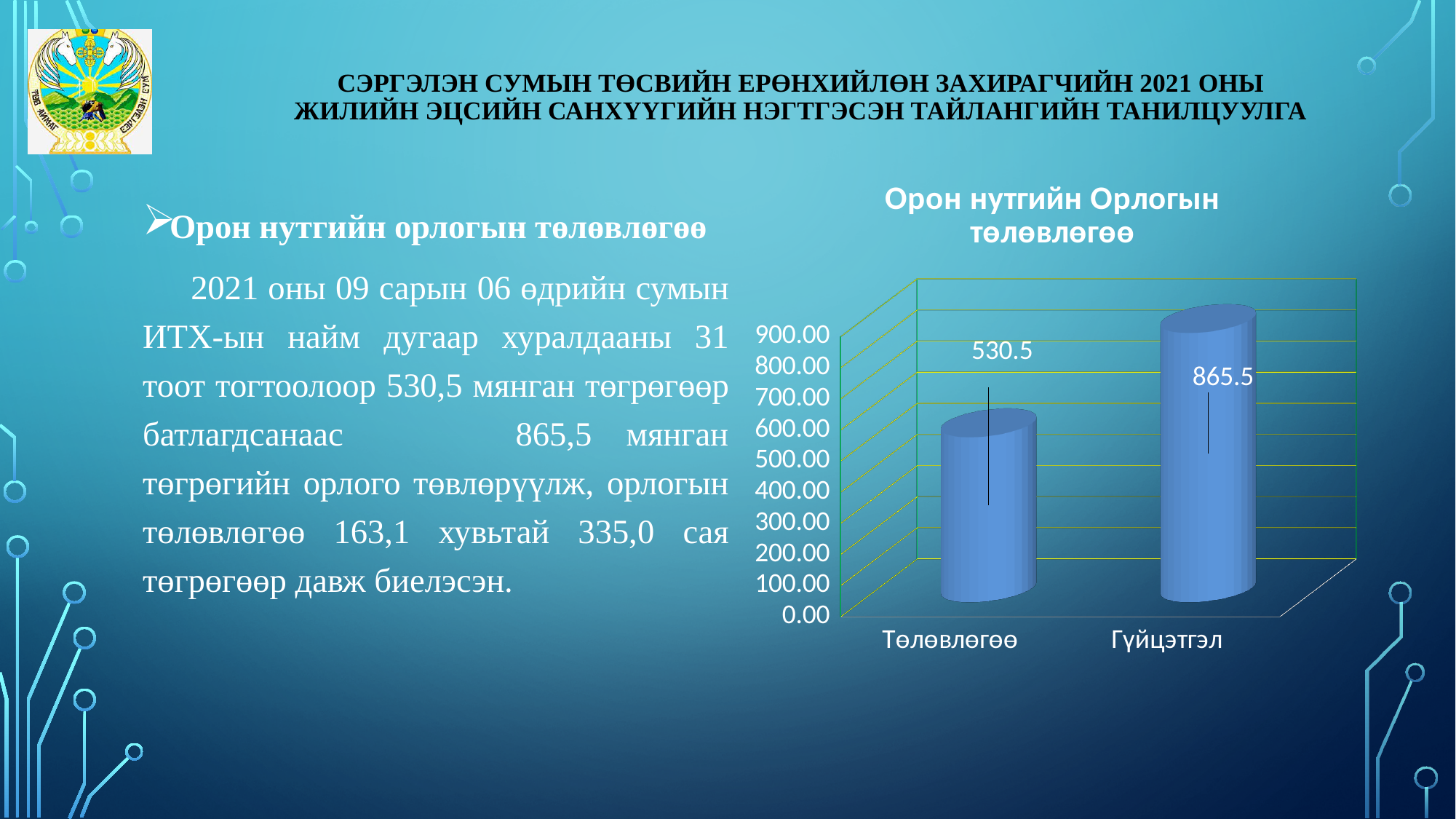
What is the difference between the values for Гүйцэтгэл and Төлөвлөгөө? 335.0 Which category has the highest value in the chart? Гүйцэтгэл What kind of chart is shown on the slide? bar chart What is the value for Гүйцэтгэл in the chart? 865.5 Is the value for Төлөвлөгөө greater or less than 600.00? less Do the values rise or fall from Төлөвлөгөө to Гүйцэтгэл? rise What is the title of the chart? Орон нутгийн Орлогын төлөвлөгөө What is the value for Төлөвлөгөө in the chart? 530.5 Which category has the lowest value in the chart? Төлөвлөгөө Which is larger, the value for Төлөвлөгөө or the value for Гүйцэтгэл? Гүйцэтгэл Is the value for Гүйцэтгэл greater or less than 800.00? greater How many categories are shown on the x axis of the chart? 2